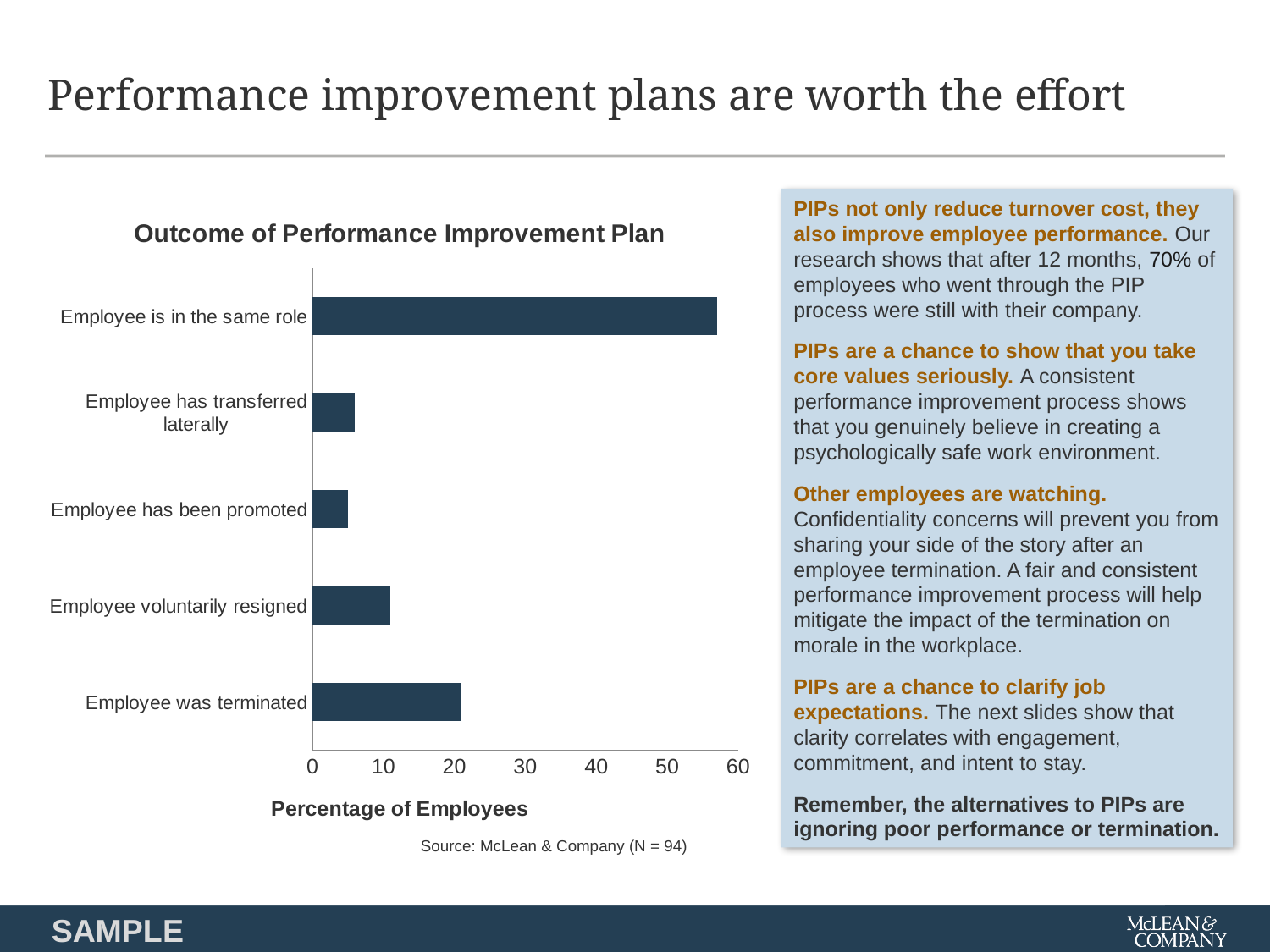
Is the value for "Employee has transferred laterally" greater or less than 10? less Which outcome has the highest percentage of employees? Employee is in the same role What type of chart is shown on the slide? Bar chart Is the value for "Employee is in the same role" greater or less than 50? greater Which is larger: the value for "Employee was terminated" or "Employee voluntarily resigned"? Employee was terminated How many outcome categories are plotted in the chart? 5 Which is larger: the value for "Employee is in the same role" or "Employee was terminated"? Employee is in the same role Is the value for "Employee voluntarily resigned" greater or less than 20? less What is the label of the horizontal axis of the chart? Percentage of Employees What is the title of the chart? Outcome of Performance Improvement Plan